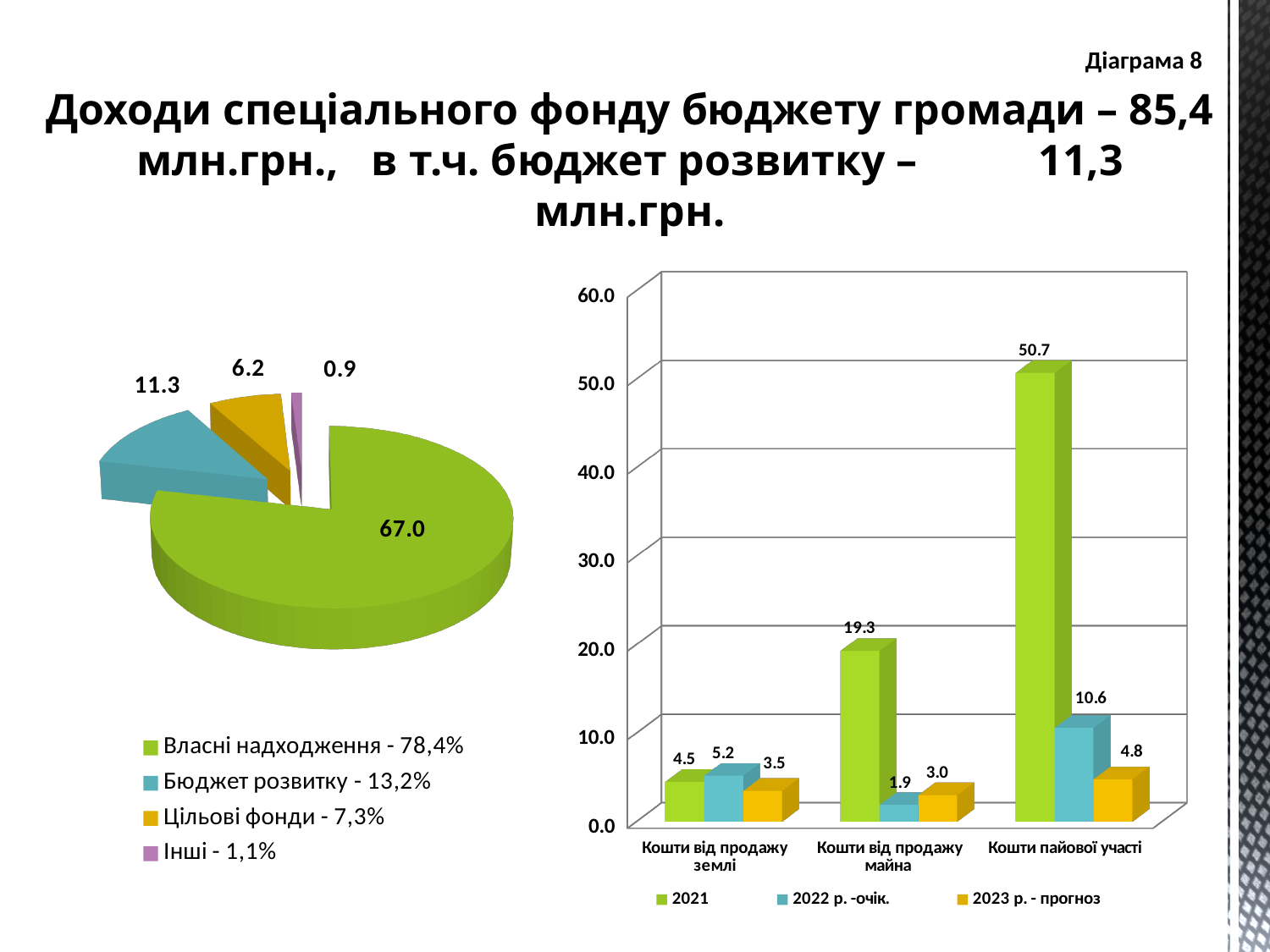
What kind of chart is shown on the right side of the slide? Bar chart On the bar chart on the right, which is larger for 'Кошти від продажу землі': the 2021 value or the '2022 р. -очік.' value? 2022 р. -очік. On the pie chart on the left, what value is shown for the slice 'Бюджет розвитку'? 11.3 On the bar chart on the right, how many series does the legend list? 3 On the bar chart on the right, what is the '2022 р. -очік.' value for 'Кошти від продажу майна'? 1.9 On the pie chart on the left, how many slices are there? 4 On the pie chart on the left, which slice is the largest? Власні надходження On the bar chart on the right, what is the 2021 value for 'Кошти пайової участі'? 50.7 On the bar chart on the right, what is the difference between the 2021 and '2022 р. -очік.' values for 'Кошти пайової участі'? 40.1 On the pie chart on the left, what share is listed in the legend for 'Цільові фонди'? 7,3% On the bar chart on the right, which category has the lowest 2021 value? Кошти від продажу землі On the bar chart on the right, what is the '2023 р. - прогноз' value for 'Кошти від продажу землі'? 3.5